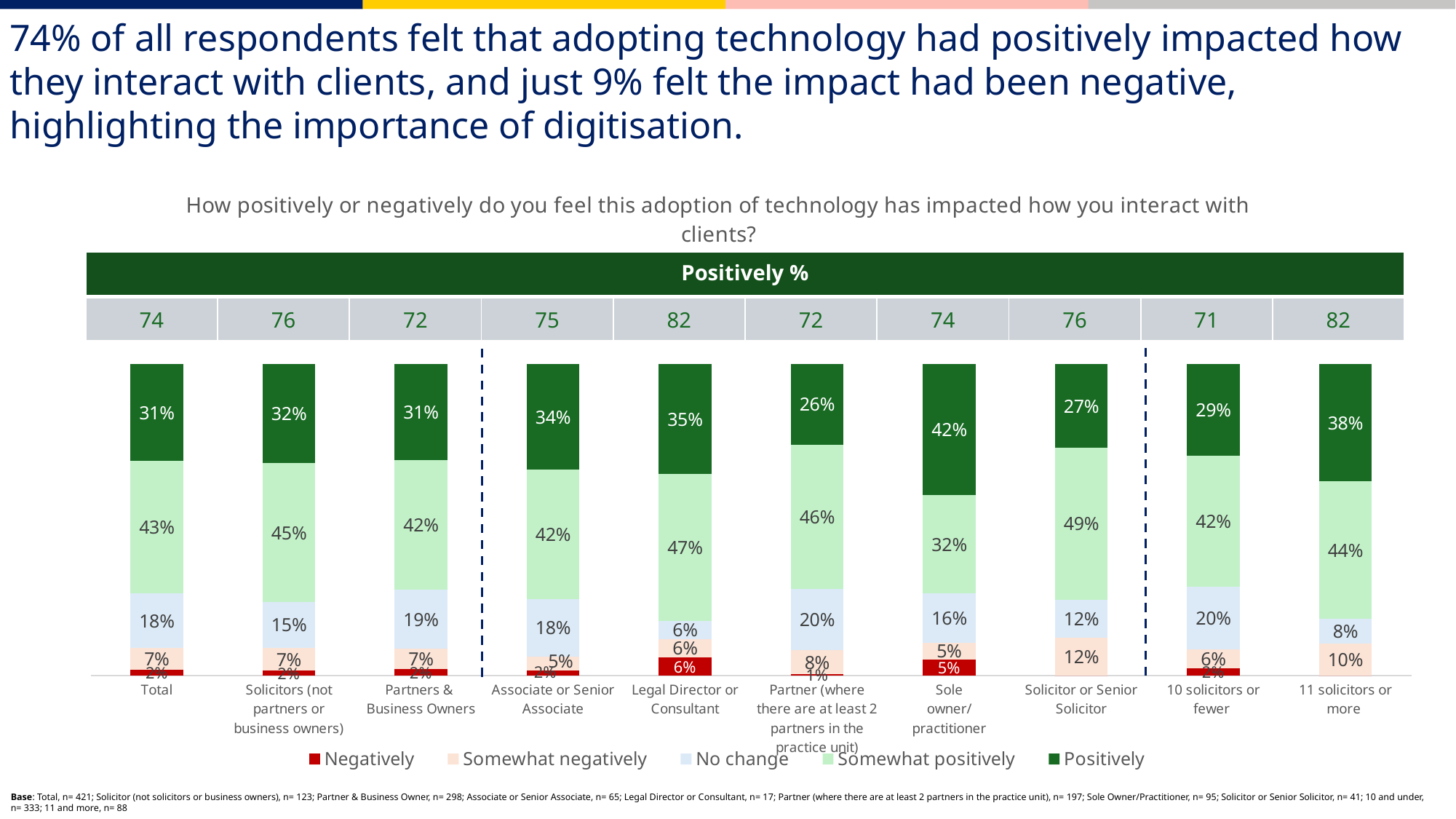
How many percentage points higher is the "Somewhat positively" value for Total than for Sole owner/practitioner? 11 How many series does the legend list? 5 What kind of chart is shown on the slide? Stacked bar chart What is the "Somewhat positively" value for Solicitor or Senior Solicitor? 49% What is the "Negatively" value for Legal Director or Consultant? 6% Which category has the highest "Positively" share? Sole owner/practitioner What is the title of the chart? How positively or negatively do you feel this adoption of technology has impacted how you interact with clients? How many categories are shown along the x axis of the chart? 10 Which category has the lowest "Positively" share? Partner (where there are at least 2 partners in the practice unit) In the "Positively %" row above the chart, what is the value for Legal Director or Consultant? 82 Which has the larger "No change" value: Partners & Business Owners or Solicitors (not partners or business owners)? Partners & Business Owners What percentage of Sole owner/practitioner respondents answered "Positively"? 42%